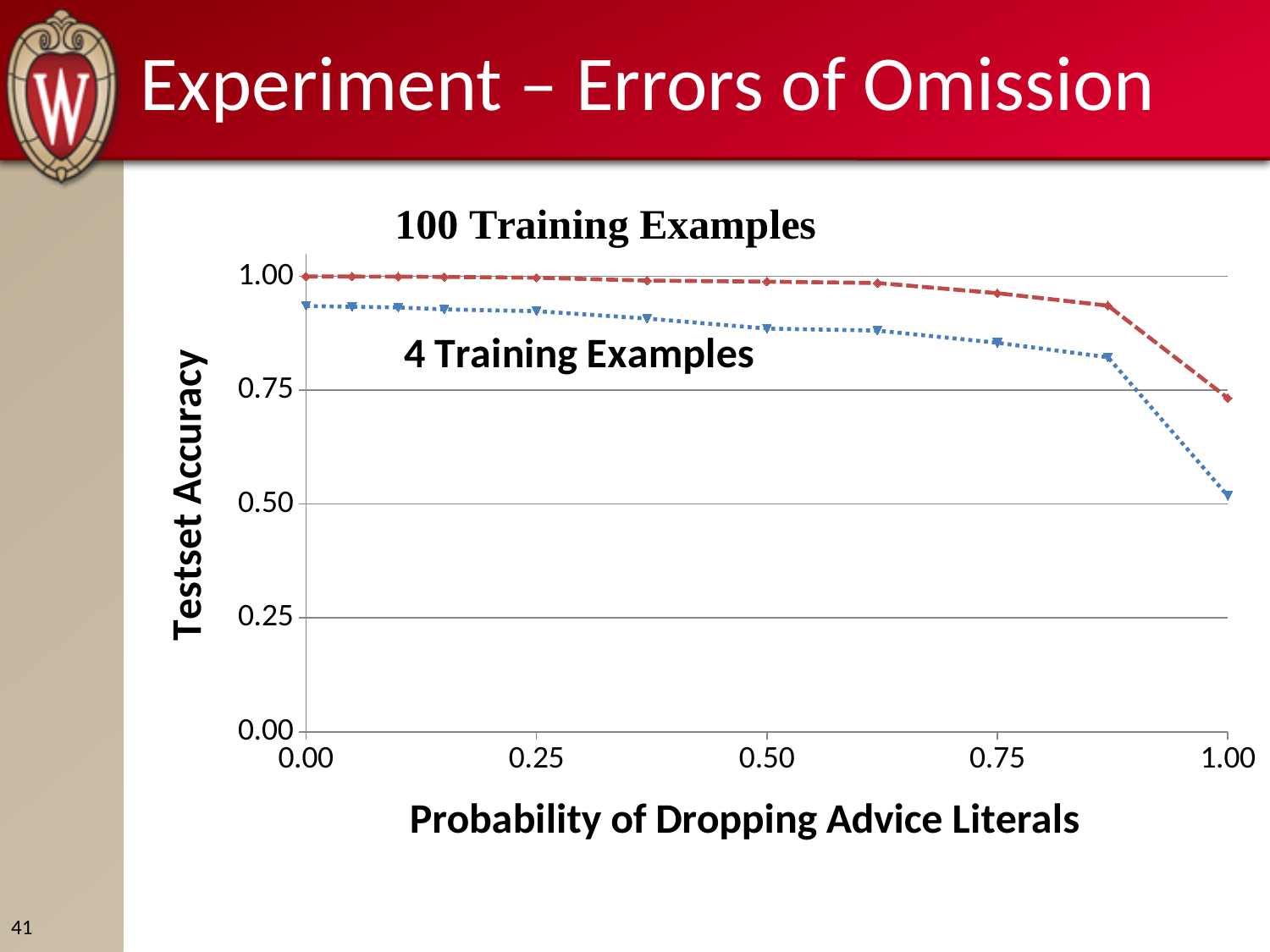
Does the Testset Accuracy for 4 Training Examples rise or fall as the Probability of Dropping Advice Literals increases? fall Is the Testset Accuracy for 4 Training Examples at a dropping probability of 1.00 greater or less than 0.75? less What is the title of the x axis? Probability of Dropping Advice Literals Is the Testset Accuracy for 4 Training Examples at a dropping probability of 0.75 greater or less than 0.75? greater What kind of chart is shown on the slide? line chart Does the Testset Accuracy for 100 Training Examples rise or fall as the Probability of Dropping Advice Literals increases? fall At a dropping probability of 1.00, which series has the higher Testset Accuracy, 100 Training Examples or 4 Training Examples? 100 Training Examples Is the Testset Accuracy for 4 Training Examples at a dropping probability of 0.00 greater or less than 0.75? greater At a dropping probability of 0.50, which series has the higher Testset Accuracy, 100 Training Examples or 4 Training Examples? 100 Training Examples How many series are plotted on the chart? 2 What is the title of the y axis? Testset Accuracy